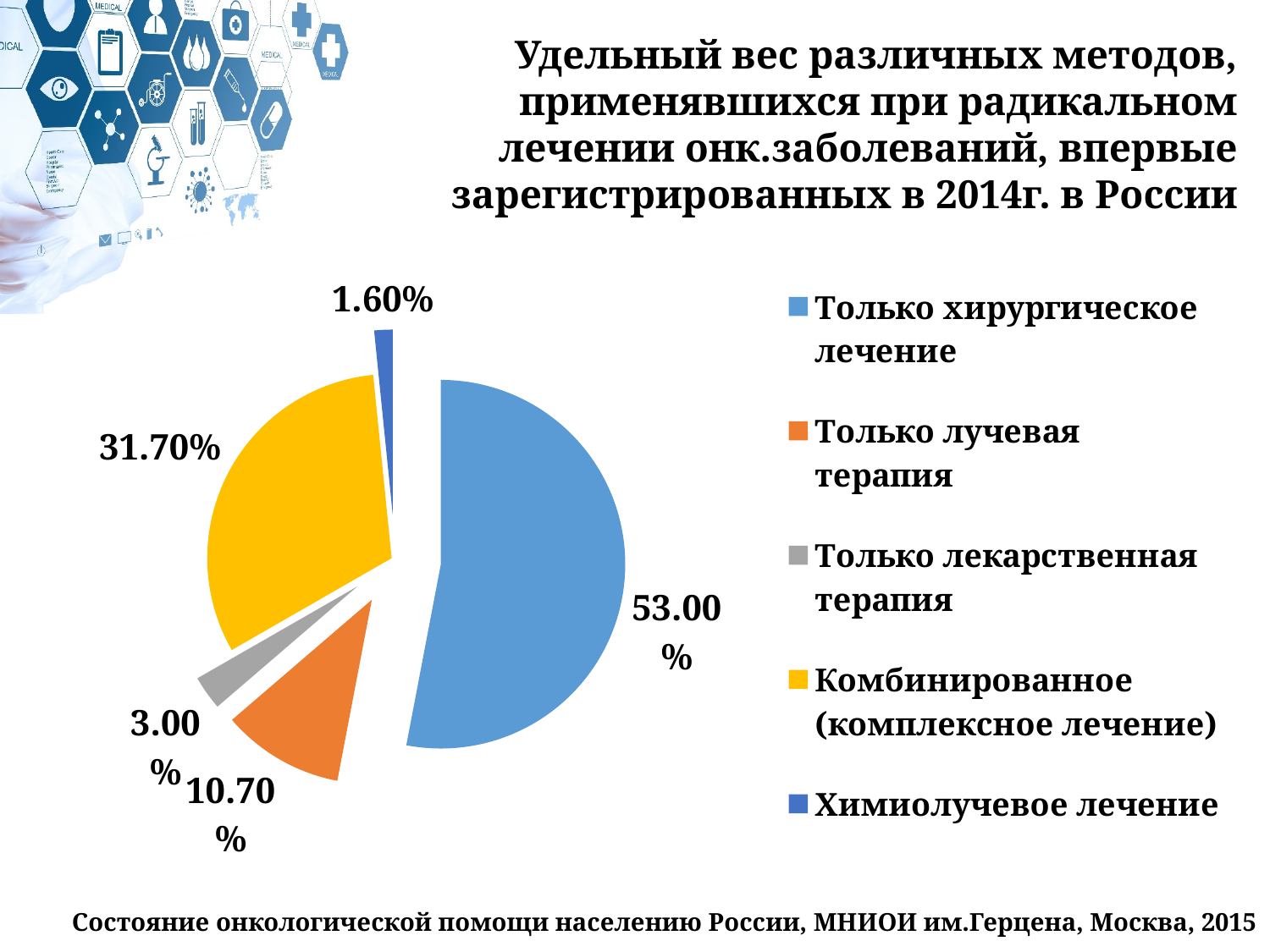
How many categories are shown in the pie chart? 5 What is the difference between the shares of "Только хирургическое лечение" and "Комбинированное (комплексное лечение)"? 21.30% What share of the pie does "Только хирургическое лечение" represent? 53.00% Which category has the largest slice of the pie? Только хирургическое лечение What colour is the slice for "Комбинированное (комплексное лечение)"? Yellow What is the difference between the shares of "Только лекарственная терапия" and "Химиолучевое лечение"? 1.40% What type of chart is shown on the slide? Pie chart What is the value shown for "Только лучевая терапия"? 10.70% What is the value shown for "Химиолучевое лечение"? 1.60% What is the value shown for "Комбинированное (комплексное лечение)"? 31.70% Which category has the smallest slice of the pie? Химиолучевое лечение Which is larger: the share of "Только лучевая терапия" or "Только лекарственная терапия"? Только лучевая терапия